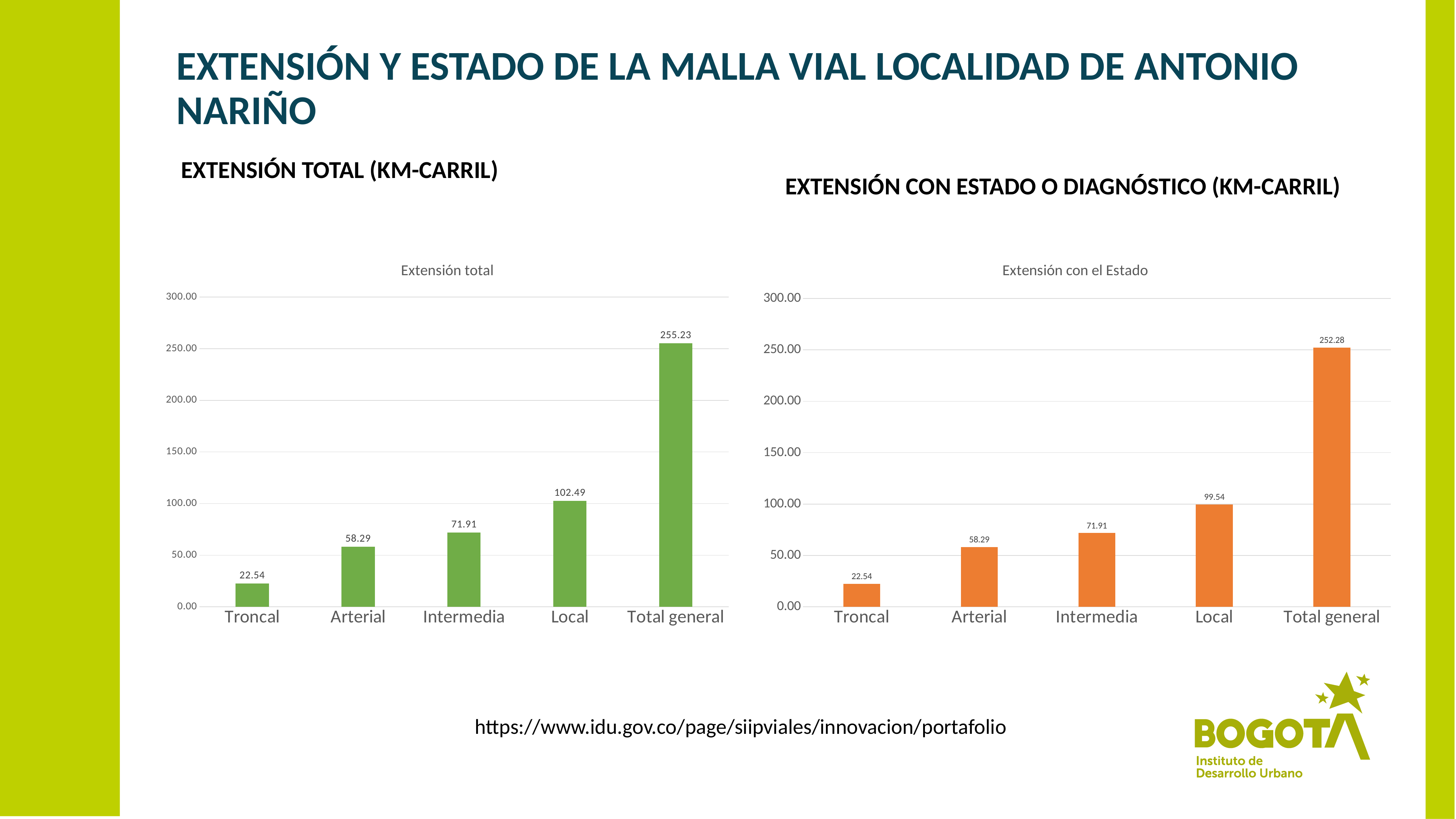
In the 'Extensión con el Estado' chart, what is the difference between Total general and Local? 152.74 In the 'Extensión total' chart, what is the value for Total general? 255.23 In the 'Extensión total' chart, what is the value for Local? 102.49 In the 'Extensión total' chart, which category has the lowest value? Troncal In the 'Extensión con el Estado' chart, which category has the highest value? Total general How many categories are shown on the x axis of the 'Extensión total' chart? 5 In the 'Extensión con el Estado' chart, what is the value for Local? 99.54 What kind of chart is the 'Extensión con el Estado' chart? Bar chart In the 'Extensión con el Estado' chart, what is the value for Troncal? 22.54 In the 'Extensión total' chart, what is the difference between Local and Intermedia? 30.58 In the 'Extensión total' chart, which is larger, Arterial or Intermedia? Intermedia In the 'Extensión con el Estado' chart, is the value for Total general greater or less than 200.00? greater